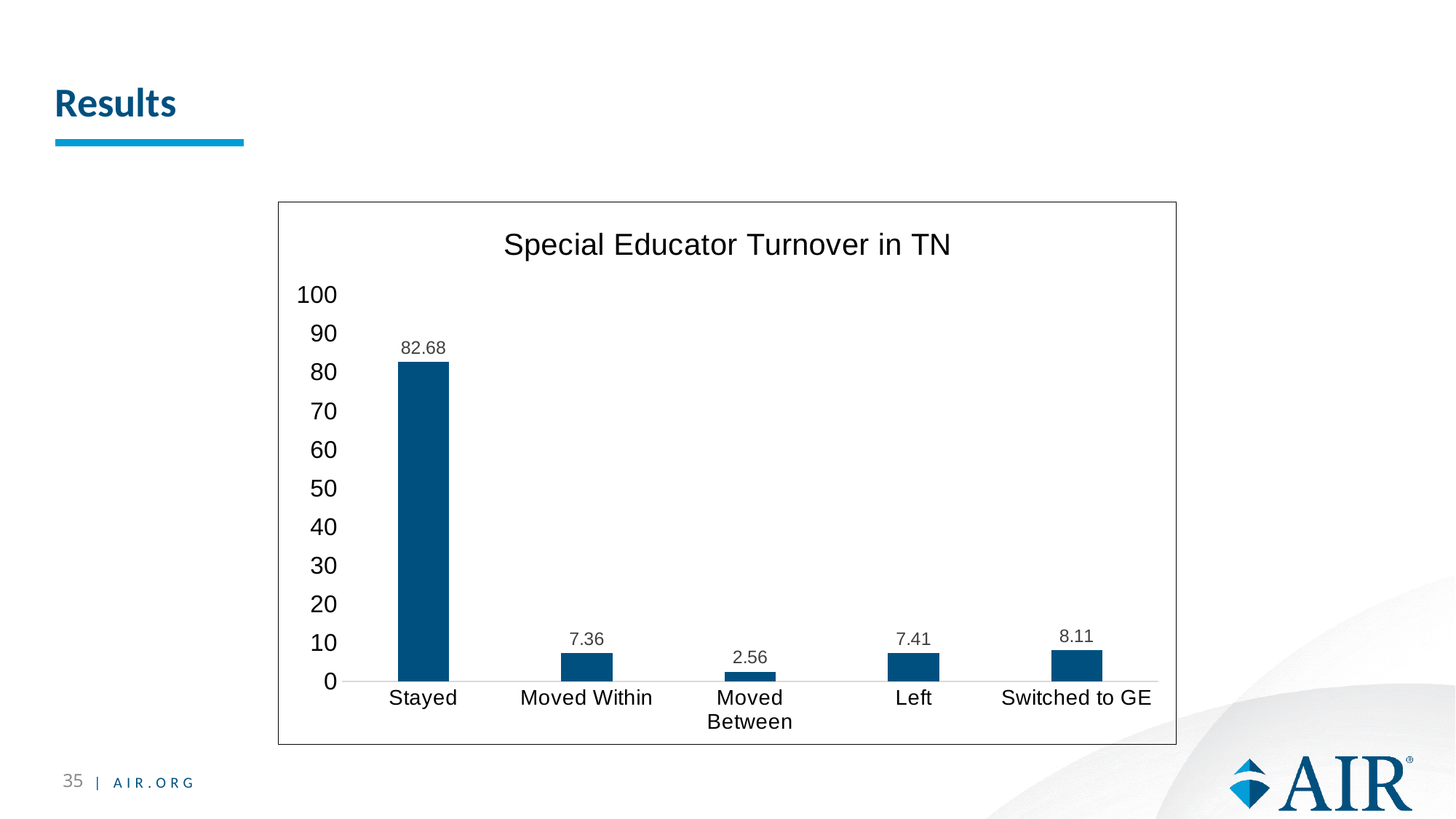
Which category has the lowest value? Moved Between How many categories are shown on the x axis? 5 What is the value for Switched to GE? 8.11 Which is larger, the value for Switched to GE or the value for Moved Between? Switched to GE What is the difference between the values for Stayed and Left? 75.27 Which category has the highest value? Stayed What kind of chart is shown on the slide? bar chart What is the difference between the values for Switched to GE and Moved Within? 0.75 What is the value for Moved Between? 2.56 What is the value for Stayed? 82.68 What is the title of the chart? Special Educator Turnover in TN Is the value for Stayed greater or less than 80? greater